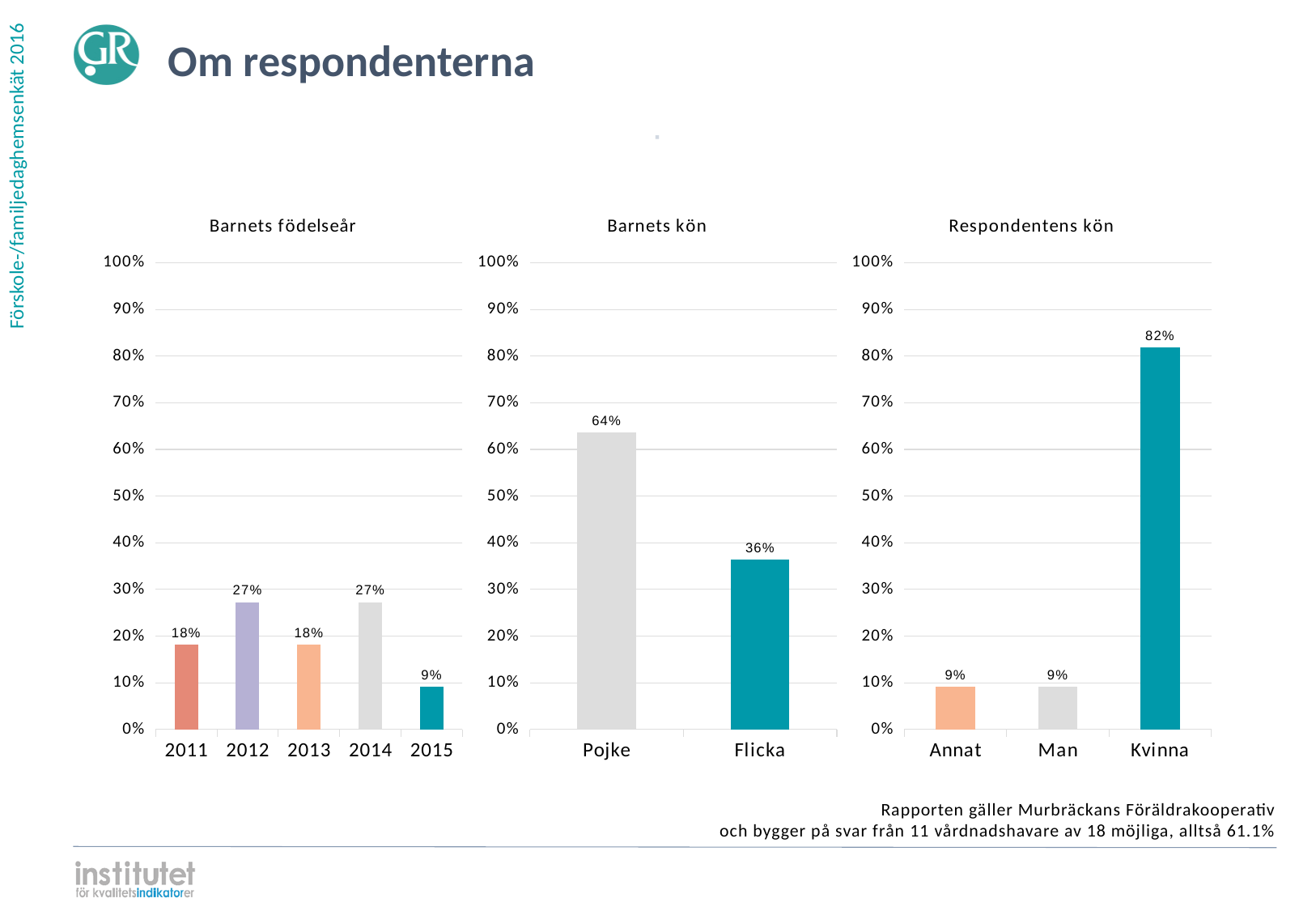
In the 'Barnets födelseår' chart, which year has the lowest value? 2015 In the 'Barnets kön' chart, what is the value for Pojke? 64% In the 'Respondentens kön' chart, which category has the highest value? Kvinna In the 'Barnets födelseår' chart, what is the value for 2015? 9% In the 'Barnets födelseår' chart, what is the value for 2011? 18% In the 'Respondentens kön' chart, what is the difference between Kvinna and Man? 73% How many charts are shown on the slide? 3 In the 'Barnets kön' chart, what is the difference between Pojke and Flicka? 28% What type of chart is the 'Barnets kön' chart? Bar chart In the 'Respondentens kön' chart, what is the value for Kvinna? 82% In the 'Barnets kön' chart, which category is higher, Pojke or Flicka? Pojke In the 'Barnets födelseår' chart, how many birth-year categories are shown? 5